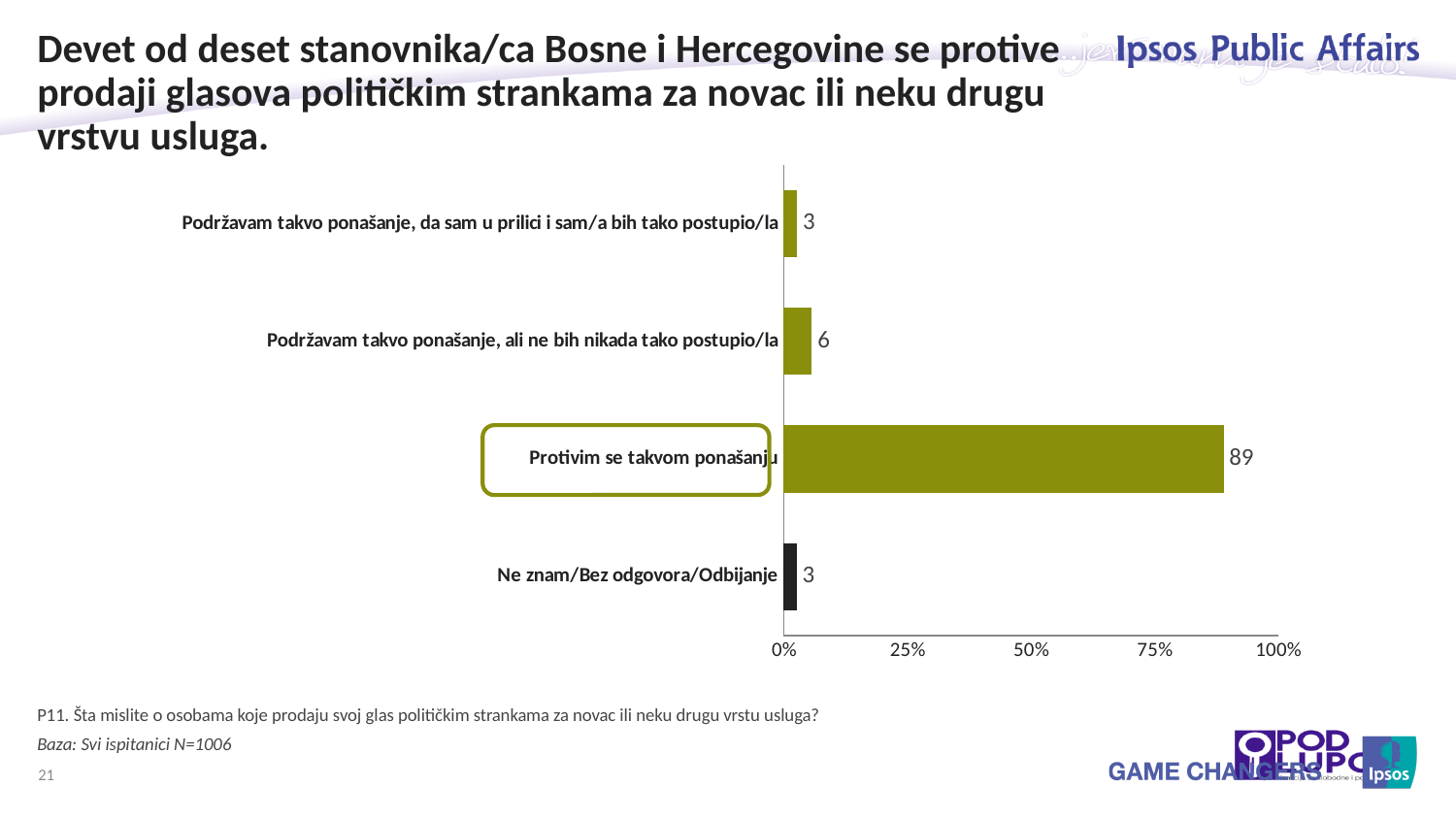
What is the value for "Podržavam takvo ponašanje, da sam u prilici i sam/a bih tako postupio/la"? 3 What kind of chart is shown on the slide? bar chart What is the highest value shown on the x axis of the chart? 100% Which category has the highest value? Protivim se takvom ponašanju How many categories are shown in the chart? 4 What is the value for "Ne znam/Bez odgovora/Odbijanje"? 3 What is the difference between the values for "Podržavam takvo ponašanje, ali ne bih nikada tako postupio/la" and "Ne znam/Bez odgovora/Odbijanje"? 3 What is the value for "Protivim se takvom ponašanju"? 89 What is the value for "Podržavam takvo ponašanje, ali ne bih nikada tako postupio/la"? 6 Is the value for "Protivim se takvom ponašanju" greater or less than 75%? greater Which is larger: the value for "Podržavam takvo ponašanje, ali ne bih nikada tako postupio/la" or the value for "Ne znam/Bez odgovora/Odbijanje"? Podržavam takvo ponašanje, ali ne bih nikada tako postupio/la What is the difference between the values for "Protivim se takvom ponašanju" and "Podržavam takvo ponašanje, ali ne bih nikada tako postupio/la"? 83